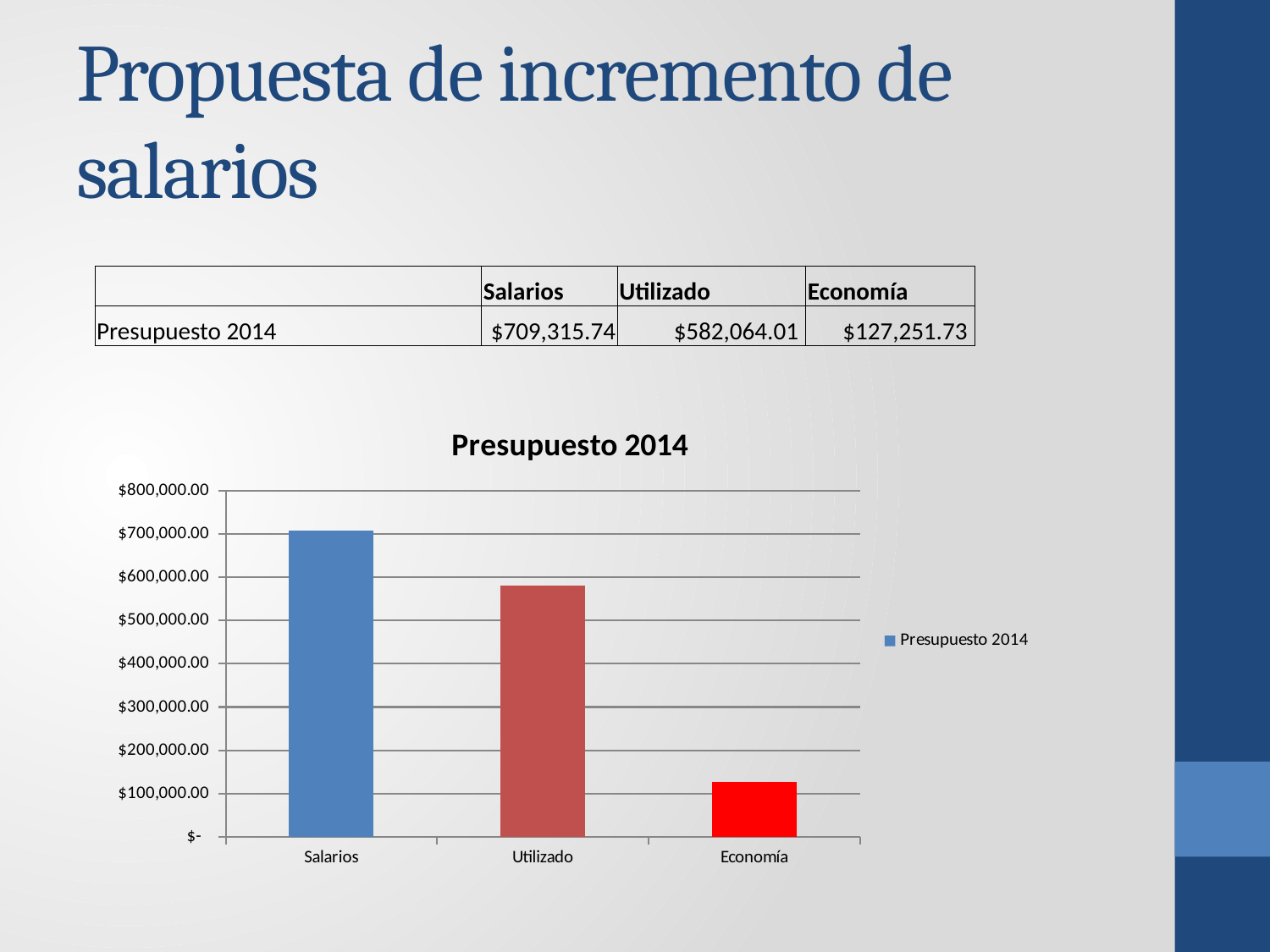
What is the title of the chart? Presupuesto 2014 What is the value for Salarios in Presupuesto 2014? $709,315.74 Which is larger, the value for Utilizado or the value for Economía? Utilizado What is the difference between the Salarios value and the Utilizado value? $127,251.73 Which category has the highest value in the chart? Salarios Is the value for Utilizado greater or less than $600,000.00? less How many series does the chart legend list? 1 What type of chart is shown on the slide? bar chart How many categories are shown on the x axis of the chart? 3 Which category has the lowest value in the chart? Economía What is the value for Economía in Presupuesto 2014? $127,251.73 What is the value for Utilizado in Presupuesto 2014? $582,064.01